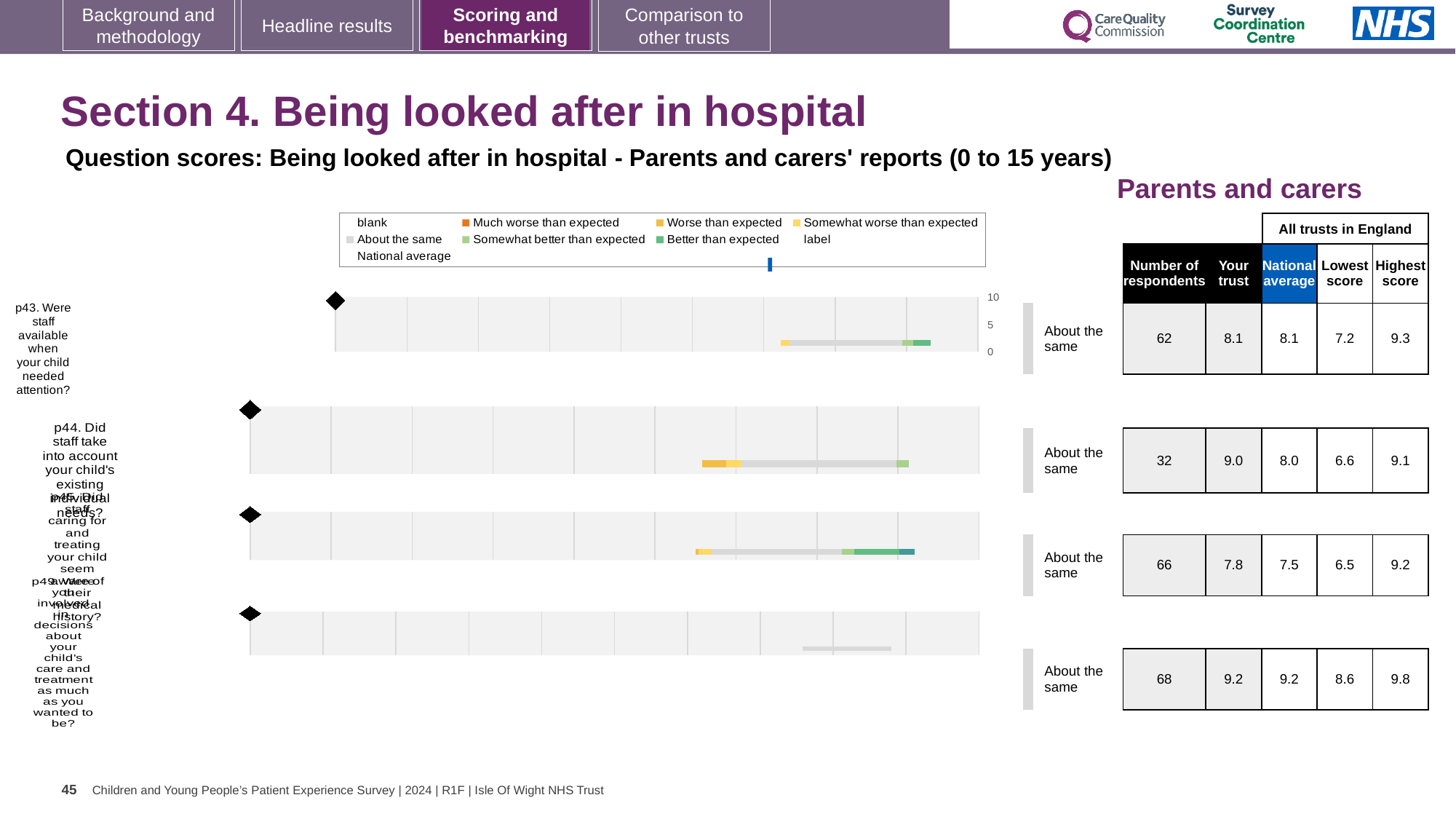
By how much does the 'Your trust' score for p44 exceed the national average for p44? 1.0 What is the 'Your trust' score for p43 (Were staff available when your child needed attention?)? 8.1 What is the lowest score across all trusts in England for p44? 6.6 What benchmark category is shown next to the bar for p43? About the same Is the 'Your trust' score for p43 greater or less than 5? greater What is the national average score for p44 (Did staff take into account your child's existing individual needs?)? 8.0 What is the highest score across all trusts in England for p43? 9.3 How many questions are plotted in the chart? 4 Which has the higher 'Your trust' score, p43 or p44? p44 Which question has the fewest respondents? p44 How many respondents are listed for p43 (Were staff available when your child needed attention?)? 62 What kind of chart is used to show the question scores? Bar chart